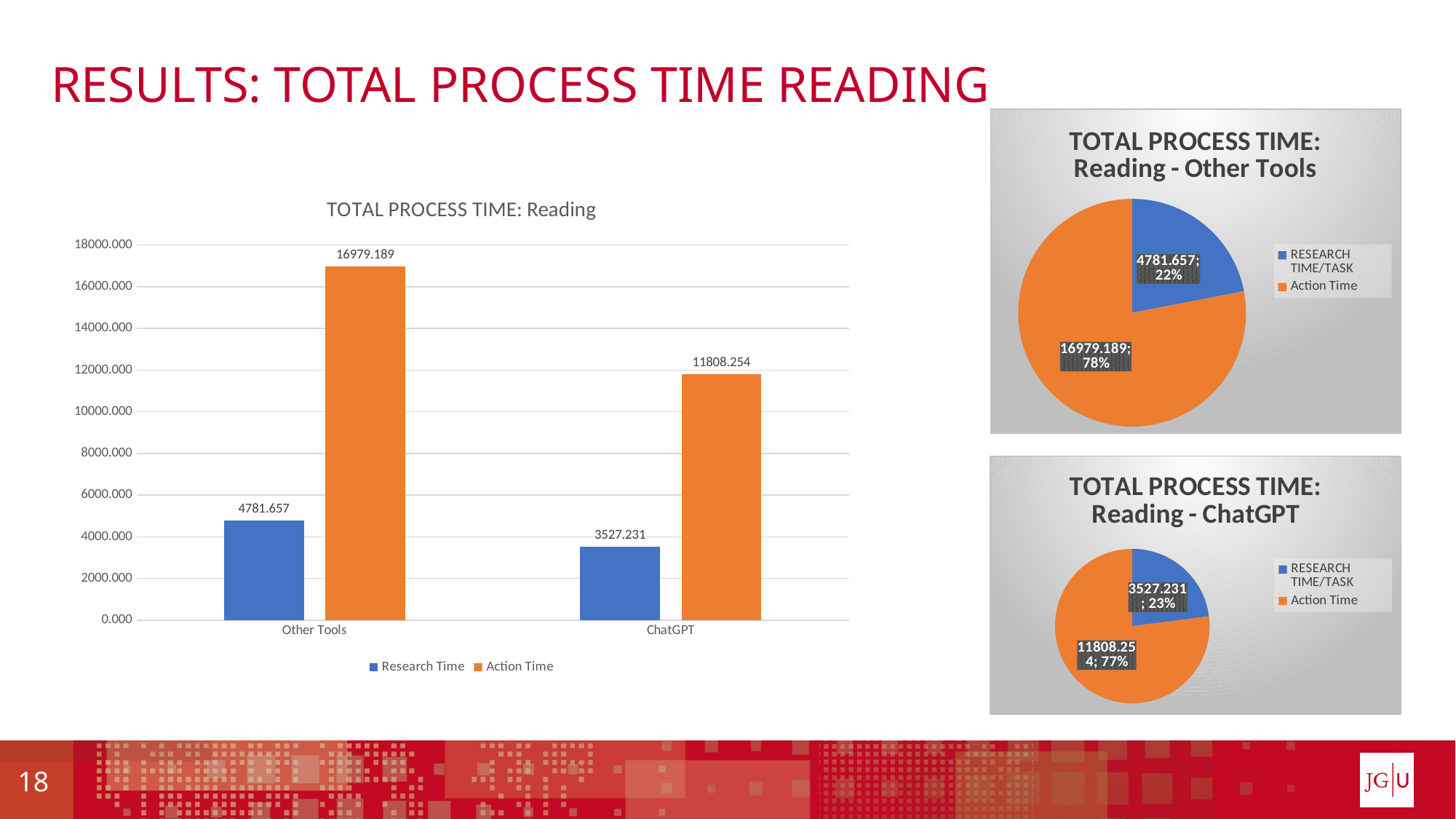
In the bar chart 'TOTAL PROCESS TIME: Reading', what is the Action Time value for Other Tools? 16979.189 In the bar chart 'TOTAL PROCESS TIME: Reading', is the Research Time for Other Tools larger or smaller than the Research Time for ChatGPT? larger In the bar chart 'TOTAL PROCESS TIME: Reading', is the Action Time for ChatGPT greater or less than 12000.000? less In the pie chart 'TOTAL PROCESS TIME: Reading - Other Tools', what share does Action Time have? 78% In the pie chart 'TOTAL PROCESS TIME: Reading - ChatGPT', what share does RESEARCH TIME/TASK have? 23% In the bar chart 'TOTAL PROCESS TIME: Reading', what colour are the Action Time bars? orange In the bar chart 'TOTAL PROCESS TIME: Reading', which category has the higher Action Time? Other Tools How many series does the legend of the bar chart 'TOTAL PROCESS TIME: Reading' list? 2 In the bar chart 'TOTAL PROCESS TIME: Reading', what is the difference between the Action Time for Other Tools and the Action Time for ChatGPT? 5170.935 What kind of chart is 'TOTAL PROCESS TIME: Reading - Other Tools'? pie chart How many categories are shown on the x axis of the bar chart 'TOTAL PROCESS TIME: Reading'? 2 In the bar chart 'TOTAL PROCESS TIME: Reading', what is the Research Time value for ChatGPT? 3527.231